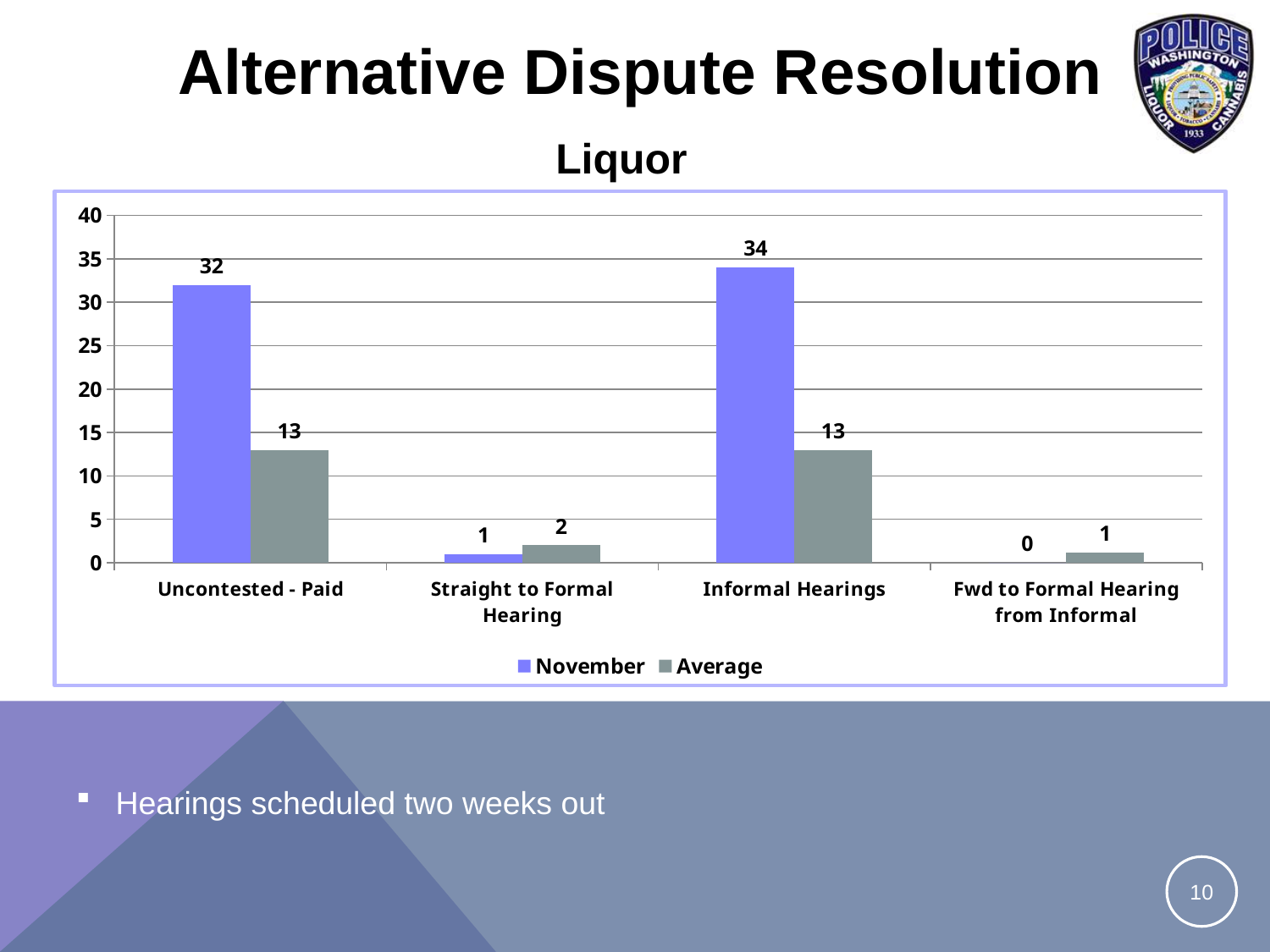
Which is larger for Straight to Formal Hearing, the November value or the Average value? Average What is the title of the chart? Liquor Which category has the lowest November value? Fwd to Formal Hearing from Informal What is the Average value for Informal Hearings? 13 How many categories are shown on the x axis? 4 What is the difference between the November and Average values for Uncontested - Paid? 19 Which category has the highest November value? Informal Hearings What kind of chart is shown on the slide? Bar chart What is the Average value for Straight to Formal Hearing? 2 What is the November value for Uncontested - Paid? 32 How many series does the legend list? 2 What is the November value for Fwd to Formal Hearing from Informal? 0